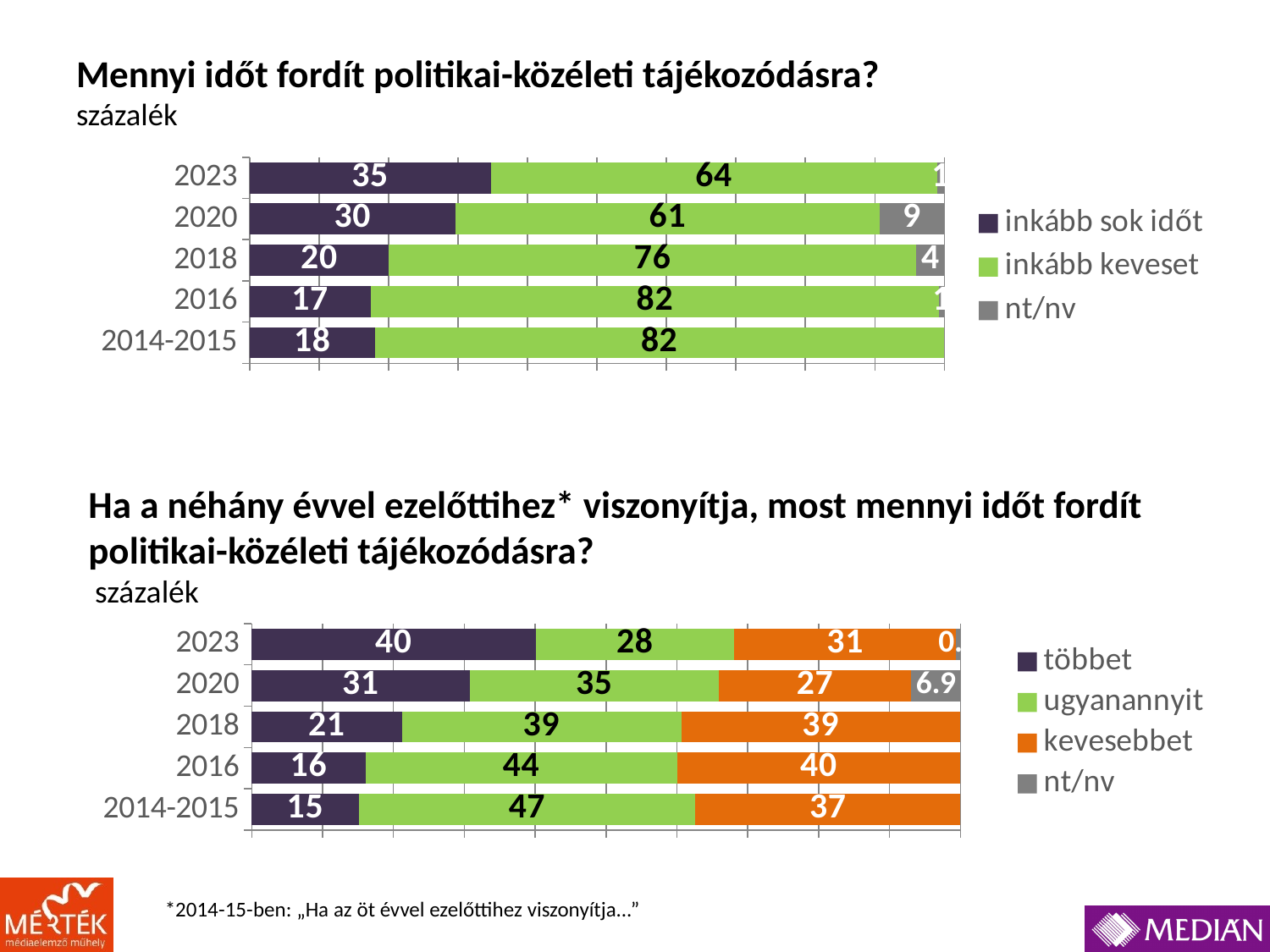
In the bottom chart (Ha a néhány évvel ezelőttihez viszonyítja...), what is the 'nt/nv' value for 2020? 6.9 In the top chart (Mennyi időt fordít politikai-közéleti tájékozódásra?), what is the 'nt/nv' value for 2020? 9 In the bottom chart (Ha a néhány évvel ezelőttihez viszonyítja...), what is the value for 'többet' in 2020? 31 In the top chart (Mennyi időt fordít politikai-közéleti tájékozódásra?), what is the difference between the 'inkább keveset' values for 2016 and 2020? 21 In the top chart (Mennyi időt fordít politikai-közéleti tájékozódásra?), what is the value for 'inkább sok időt' in 2023? 35 In the top chart (Mennyi időt fordít politikai-közéleti tájékozódásra?), how many series does the legend list? 3 In the top chart (Mennyi időt fordít politikai-közéleti tájékozódásra?), which year has the highest value for 'inkább sok időt'? 2023 In the top chart (Mennyi időt fordít politikai-közéleti tájékozódásra?), what is the value for 'inkább keveset' in 2018? 76 In the bottom chart (Ha a néhány évvel ezelőttihez viszonyítja...), which year has the lowest value for 'többet'? 2014-2015 In the bottom chart (Ha a néhány évvel ezelőttihez viszonyítja...), how does the 'többet' value change from 2014-2015 to 2023? It rises In the bottom chart (Ha a néhány évvel ezelőttihez viszonyítja...), is the 'ugyanannyit' value larger in 2014-2015 or in 2023? 2014-2015 What type of chart is the bottom chart (Ha a néhány évvel ezelőttihez viszonyítja...)? Stacked bar chart